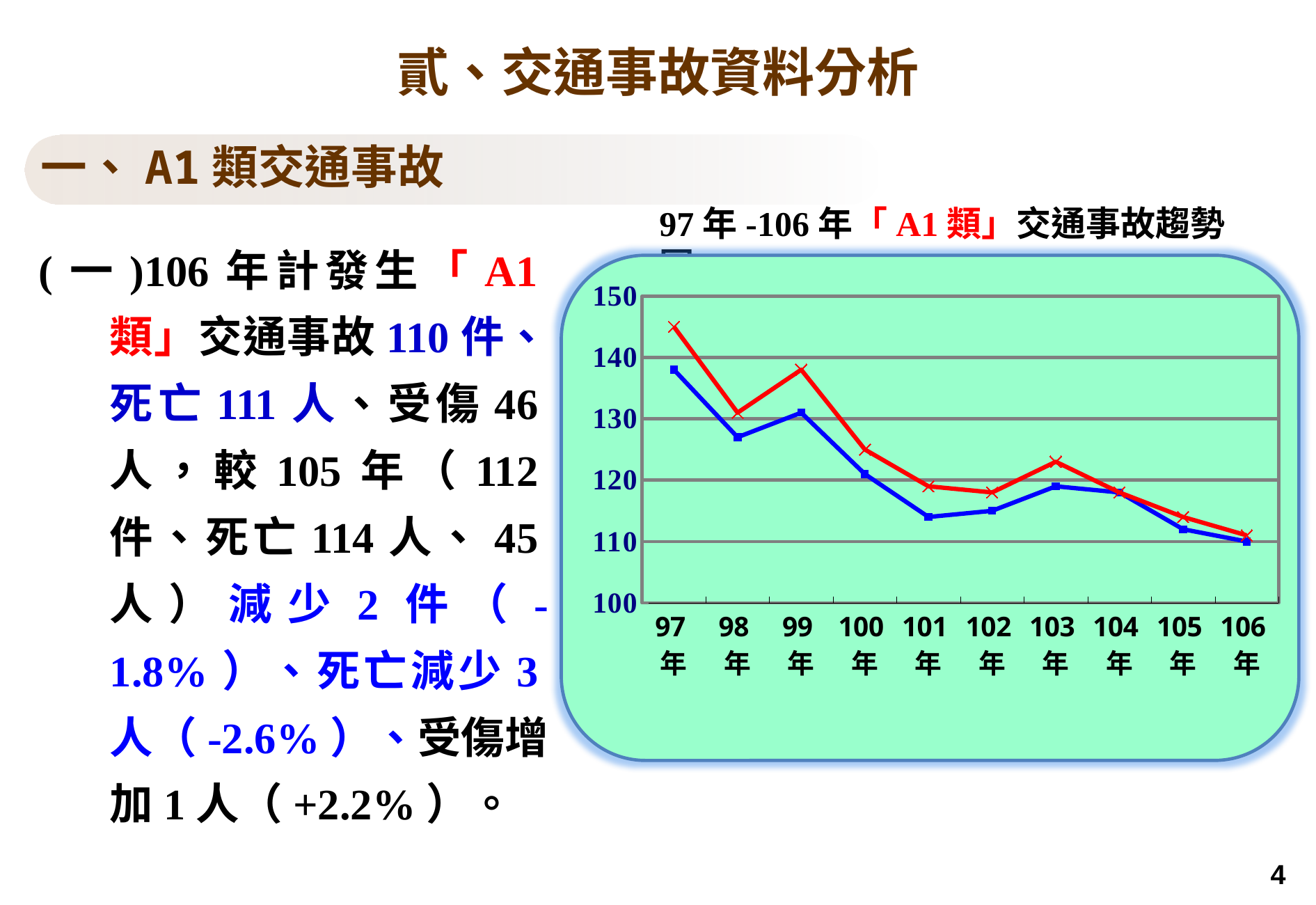
Is the value of the blue line at 97年 greater or less than 130? greater In which year does the blue line reach its lowest value? 106年 What kind of chart is shown on the slide? line chart Is the value of the blue line at 101年 greater or less than 120? less How many years are plotted along the x axis of the chart? 10 Is the value of the red line at 97年 greater or less than 140? greater In which year does the red line reach its highest value? 97年 How many lines are plotted in the chart? 2 On the red line, is the value at 99年 higher or lower than the value at 98年? higher Do the values in the chart generally rise or fall from 97年 to 106年? fall On the blue line, is the value at 103年 higher or lower than the value at 101年? higher